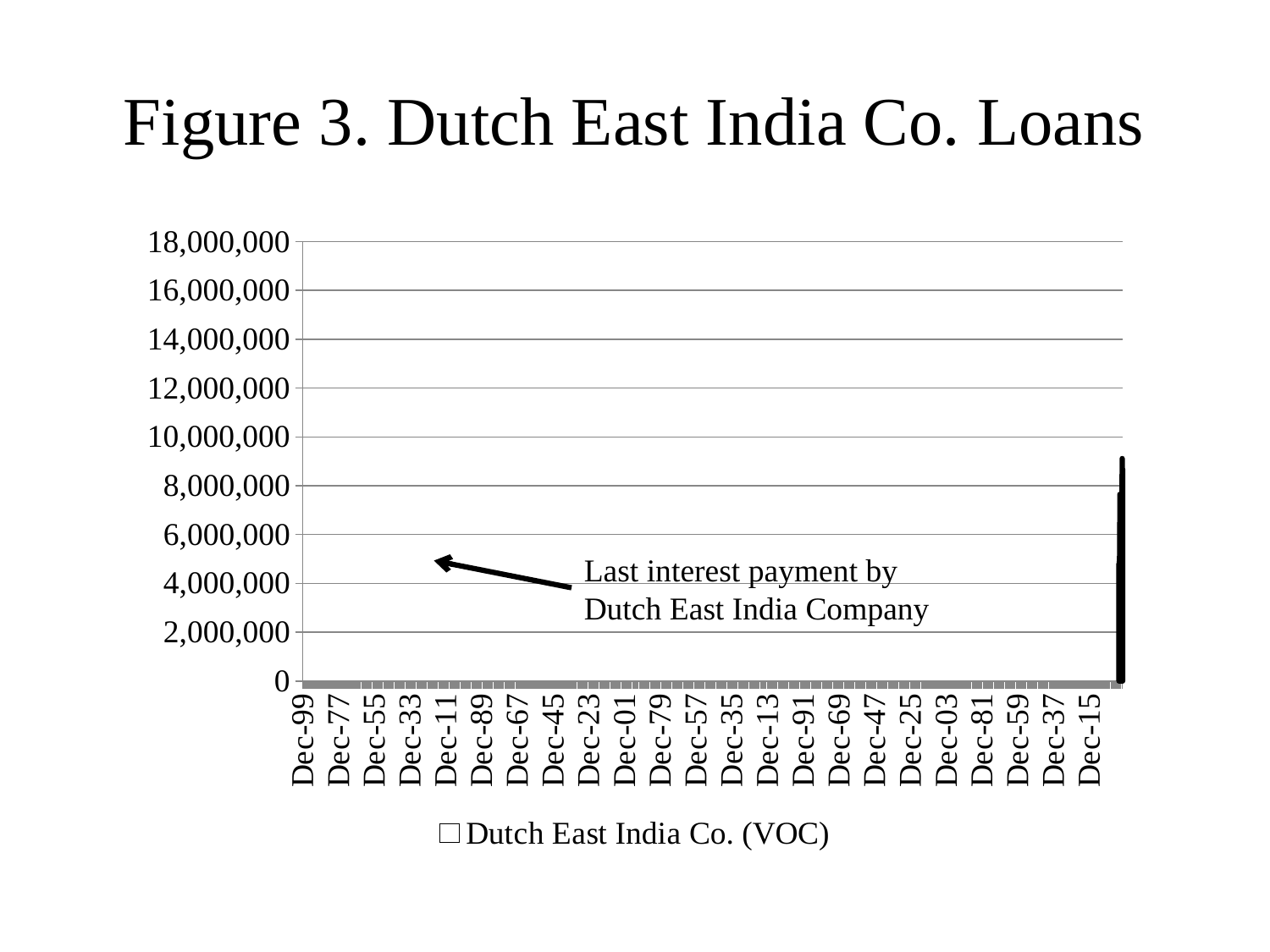
Is the tallest bar in the chart greater or less than 6,000,000? greater What is the lowest value shown on the y axis? 0 Is the tallest bar in the chart greater or less than 10,000,000? less What kind of chart is shown on the slide? area chart How many series does the legend list? 1 What is the highest value shown on the y axis? 18,000,000 What is the title of the chart? Figure 3. Dutch East India Co. Loans What is the name of the series shown in the legend? Dutch East India Co. (VOC) Is the tallest bar in the chart greater or less than 8,000,000? greater Do the values stay flat or rise sharply at the right end of the x axis? rise sharply